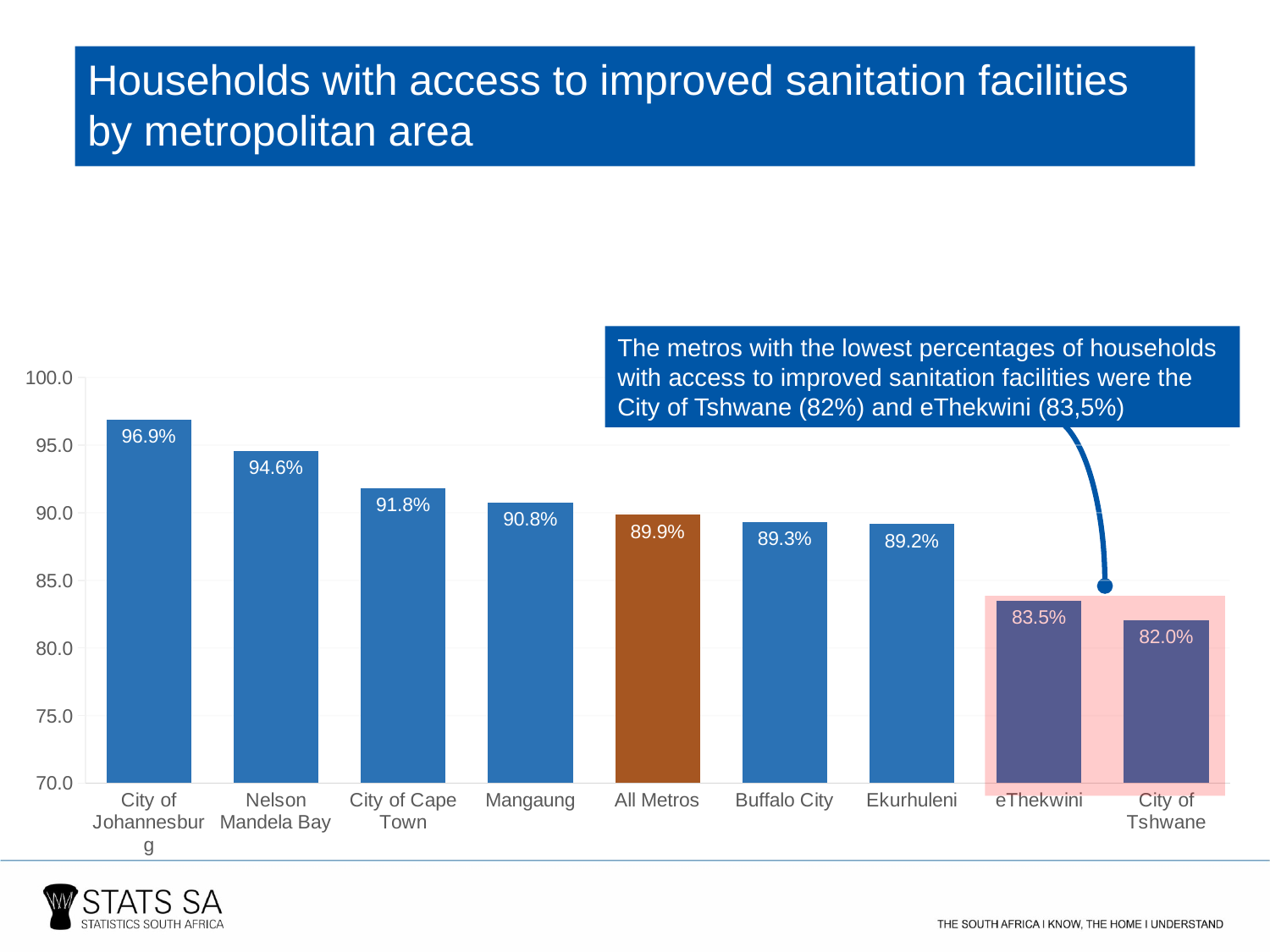
Which metropolitan area has the lowest value? City of Tshwane What is the value for eThekwini? 83.5% What kind of chart is shown on the slide? bar chart Which is larger, the value for Mangaung or the value for Buffalo City? Mangaung Do the values rise or fall from left to right along the x axis? fall What is the value for City of Johannesburg? 96.9% What is the difference between the values for Nelson Mandela Bay and City of Cape Town? 2.8% Which metropolitan area has the highest value? City of Johannesburg Is the value for Ekurhuleni greater or less than 90.0? less What is the value for All Metros? 89.9% What is the difference between the values for City of Johannesburg and City of Tshwane? 14.9% How many categories are shown on the x axis? 9